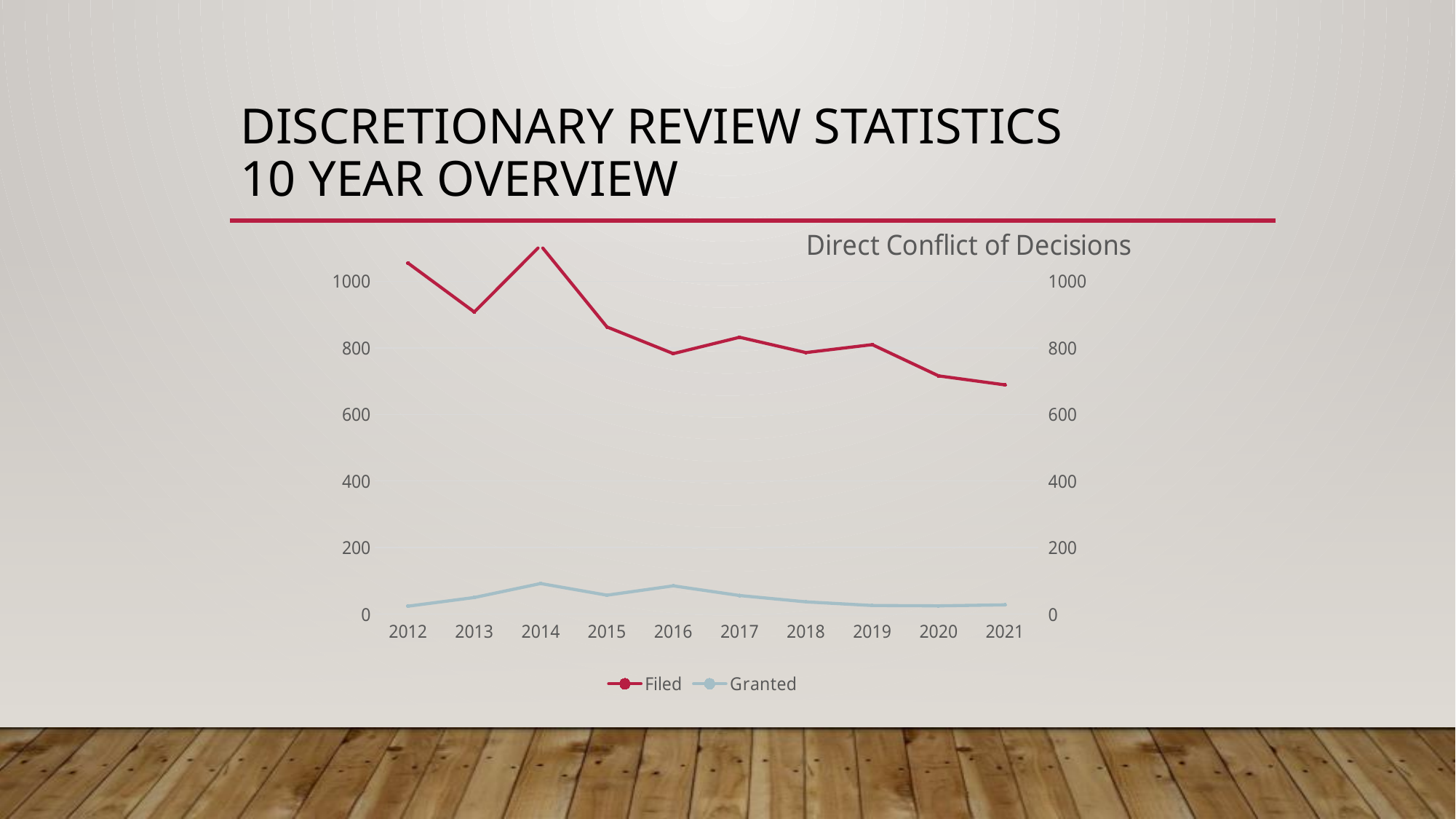
What are the two series named in the legend? Filed and Granted Is the Granted value for 2014 greater or less than 200? less Which is larger, the Filed value for 2013 or for 2014? 2014 How many series does the legend list? 2 Overall, does the Filed series rise or fall from 2012 to 2021? fall What kind of chart is shown on the slide? line chart Is the Filed value for 2012 greater or less than 1000? greater In which year is the Filed series at its highest? 2014 What is the title of the chart? Direct Conflict of Decisions How many years are shown on the x axis? 10 In which year is the Filed series at its lowest? 2021 Is the Filed value for 2021 greater or less than 800? less